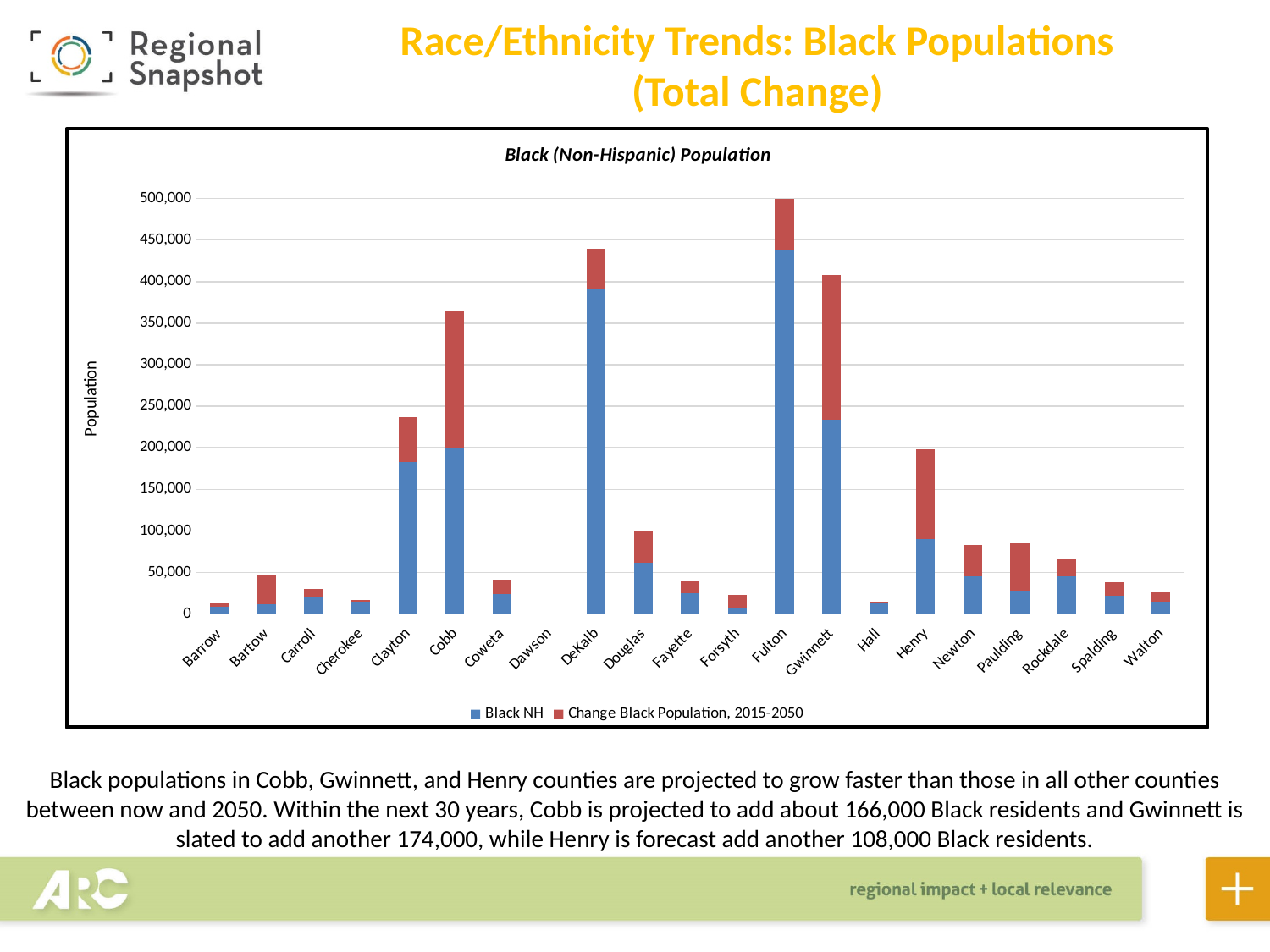
Which county has the larger Black NH (blue) segment, Fulton or DeKalb? Fulton Is the total bar for Clayton greater or less than 200,000? greater Which county has the tallest total bar in the chart? Fulton Is the total bar for Hall greater or less than 50,000? less What is the title printed inside the chart area? Black (Non-Hispanic) Population Which county has the larger total bar, Cobb or Clayton? Cobb Is the total bar for DeKalb greater or less than 400,000? greater How many counties are shown along the x axis of the chart? 21 Which county has the smallest total bar in the chart? Dawson What kind of chart is shown on the slide? Stacked bar chart How many series does the chart legend list? 2